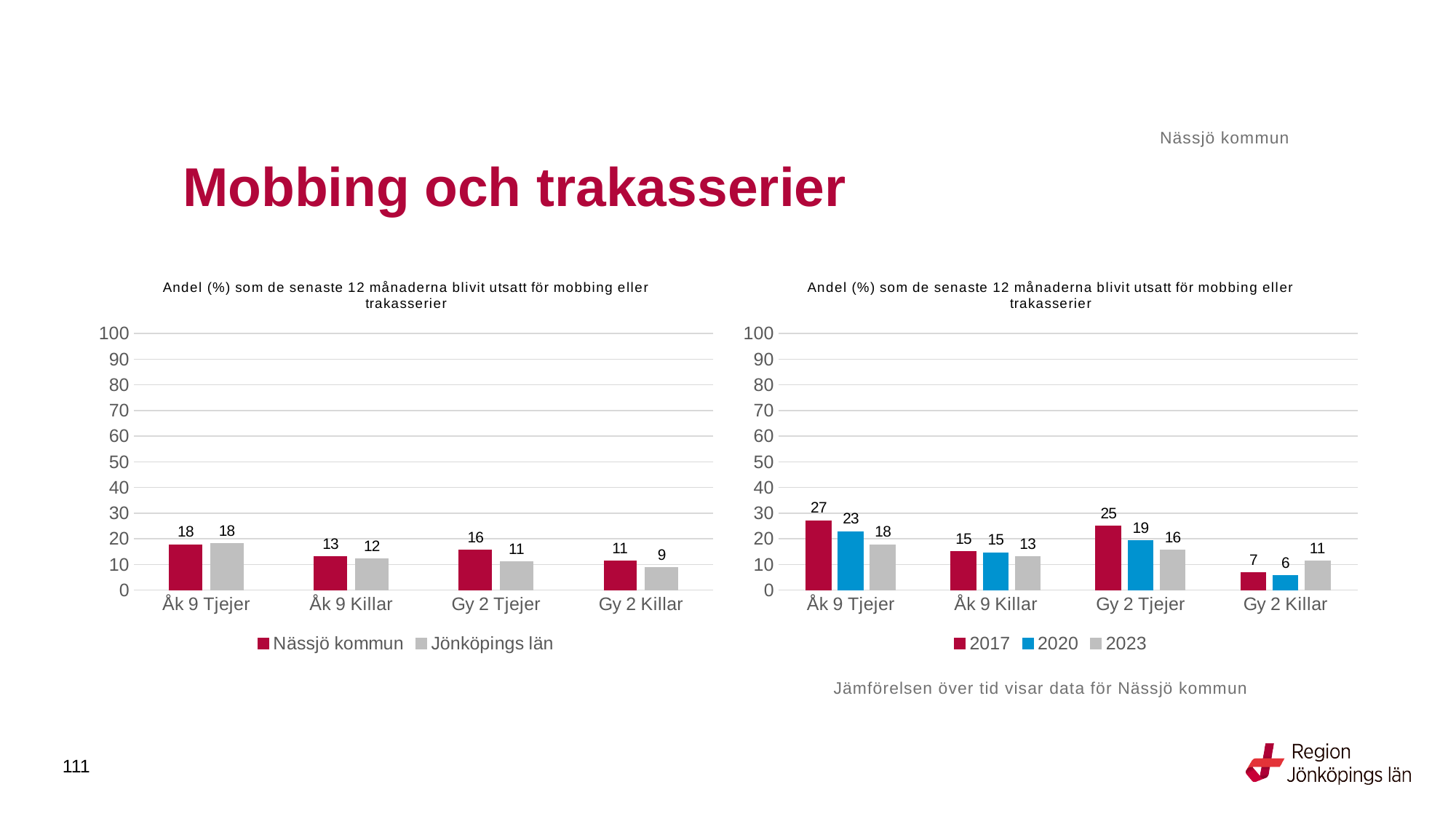
In the left chart, what is the difference between Nässjö kommun and Jönköpings län for Gy 2 Tjejer? 5 In the right chart, which category has the highest value for 2017? Åk 9 Tjejer In the left chart, what is the value for Jönköpings län for Gy 2 Killar? 9 In the right chart, what is the difference between the 2017 and 2023 values for Åk 9 Tjejer? 9 In the right chart, which category has the lowest value for 2020? Gy 2 Killar In the right chart, which is larger for Gy 2 Killar: the 2017 value or the 2023 value? 2023 In the right chart, what is the value for 2023 for Gy 2 Killar? 11 In the right chart, what is the value for 2017 for Gy 2 Tjejer? 25 In the left chart, what is the value for Nässjö kommun for Åk 9 Killar? 13 How many series does the legend of the right chart list? 3 How many categories are shown on the x axis of the left chart? 4 What kind of chart is the left chart? Bar chart